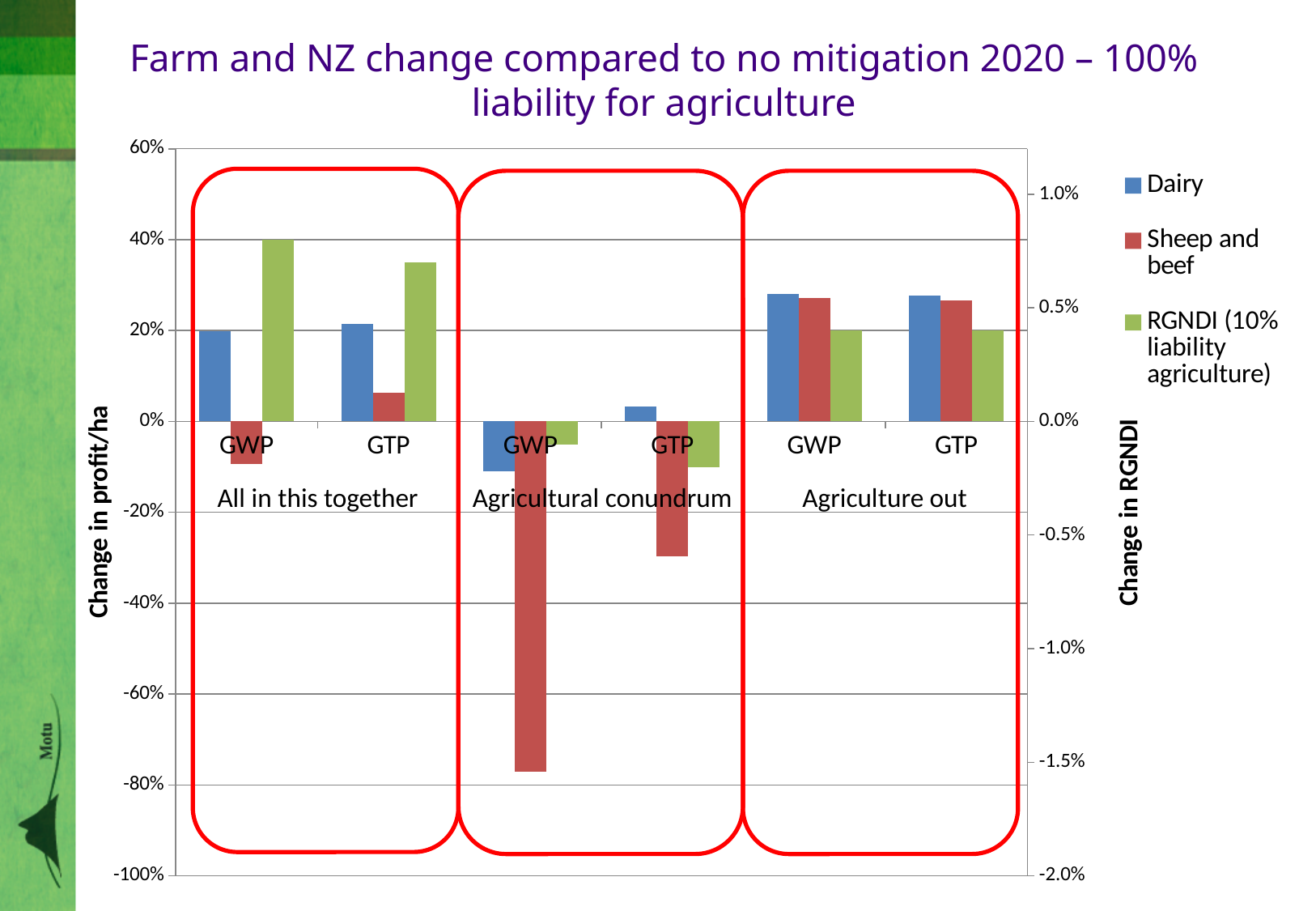
How many series does the legend list? 3 For GWP under All in this together, which is larger: Dairy or Sheep and beef? Dairy How many scenario groups (red-outlined boxes) are shown on the chart? 3 What is the title of the right vertical axis? Change in RGNDI What kind of chart is shown on the slide? Bar chart In which scenario and metric is the Sheep and beef bar lowest? Agricultural conundrum, GWP In which scenario and metric is the RGNDI (10% liability agriculture) bar highest? All in this together, GWP For GTP under Agricultural conundrum, which is larger: Dairy or Sheep and beef? Dairy What is the title of the left vertical axis? Change in profit/ha Is the Dairy value for GWP under Agriculture out greater or less than 20%? greater Is the Sheep and beef value for GWP under Agricultural conundrum greater or less than -60%? less Is the Sheep and beef value for GTP under Agricultural conundrum greater or less than -20%? less